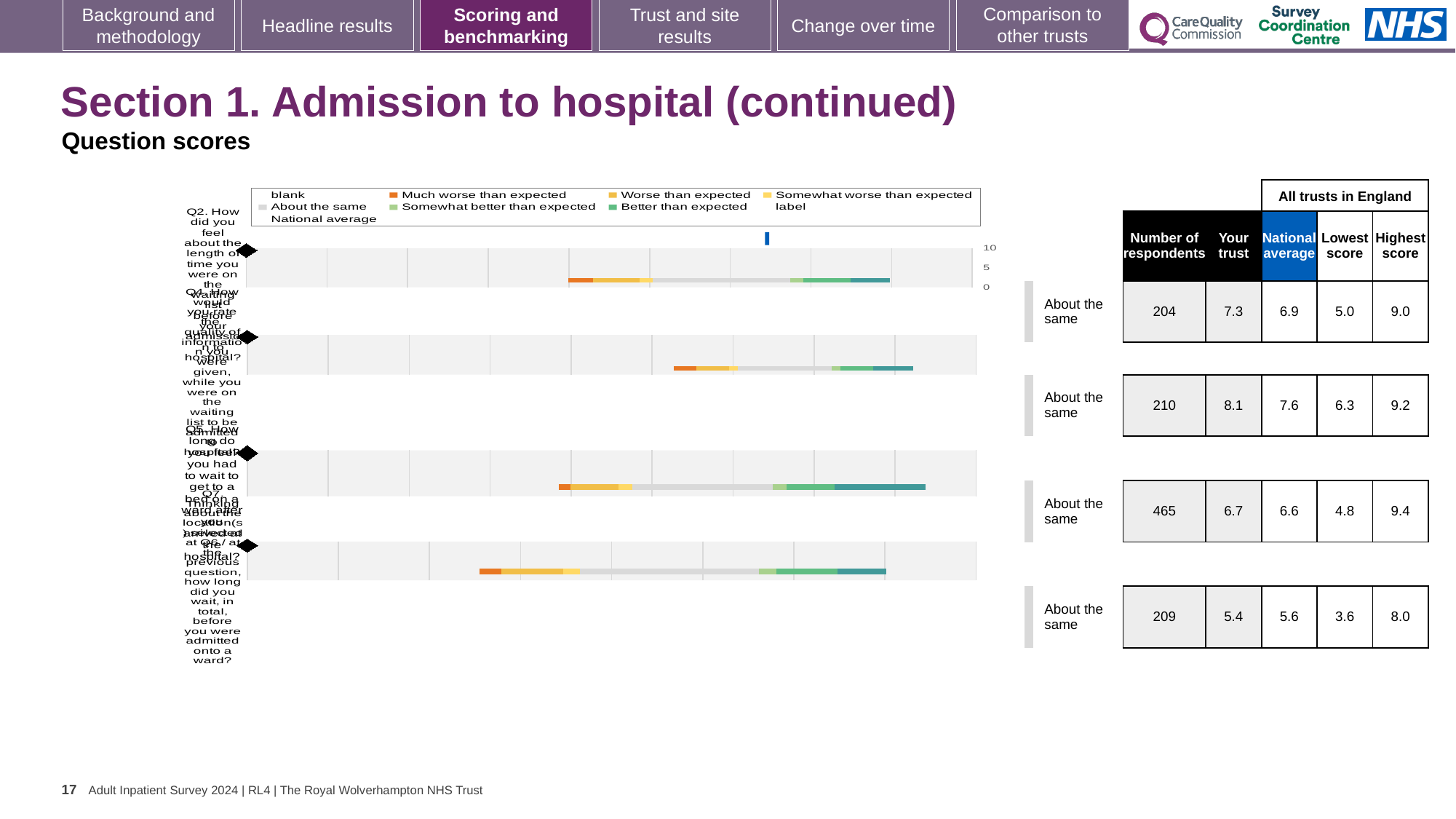
How many question rows (bars) does the chart show? 4 In the table beside the chart, which row has the highest number of respondents? the third row (465) In the table beside the chart, what is the number of respondents in the first row? 204 What kind of chart is shown on the slide? bar chart In the table beside the chart, what is the 'Your trust' score in the second row? 8.1 In the table beside the chart, what is the difference between the 'Your trust' score and the national average in the first row? 0.4 In the table beside the chart, in the fourth row, which is larger: the 'Your trust' score or the national average? National average What benchmark category label is shown next to each of the four bars? About the same In the table beside the chart, which row has the smallest 'Lowest score' value? the fourth row (3.6) What is the maximum value shown on the chart's score axis? 10 In the table beside the chart, what is the national average in the second row? 7.6 In the table beside the chart, what is the highest score in the third row? 9.4